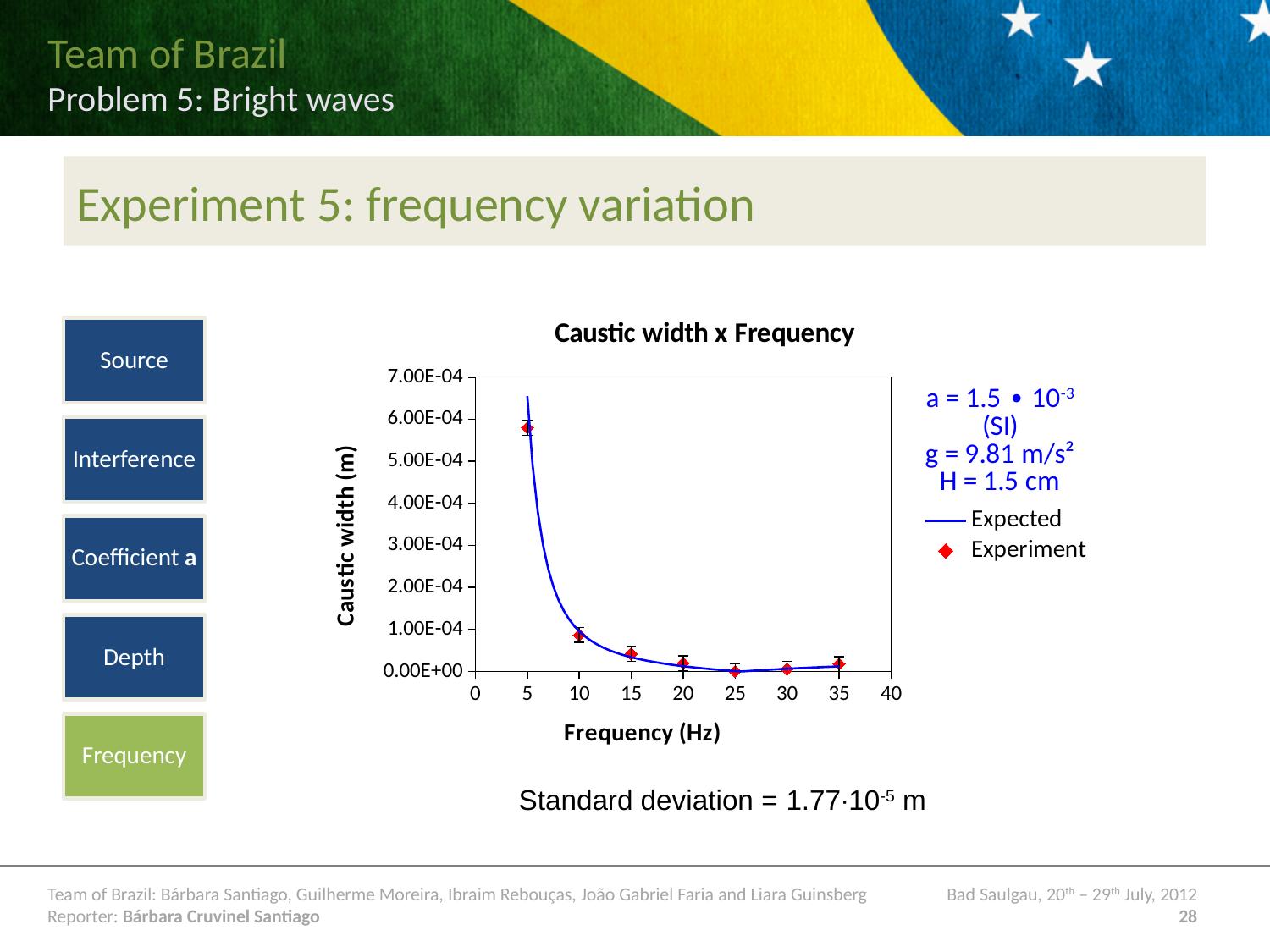
What is the title of the chart? Caustic width x Frequency Is the Experiment value at 5 Hz greater or less than 5.00E-04 m? greater At which frequency is the measured caustic width highest? 5 Hz Is the Experiment value at 15 Hz greater or less than 1.00E-04 m? less What kind of chart is shown on the slide? Scatter chart with a fitted line Which has the larger measured caustic width, 5 Hz or 10 Hz? 5 Hz How many Experiment data points are plotted on the chart? 7 Does the caustic width rise or fall as frequency increases from 5 Hz to 25 Hz? Fall What are the two series named in the chart legend? Expected and Experiment Is the Experiment value at 10 Hz greater or less than 2.00E-04 m? less What is the label of the x axis? Frequency (Hz) How many series does the chart legend list? 2